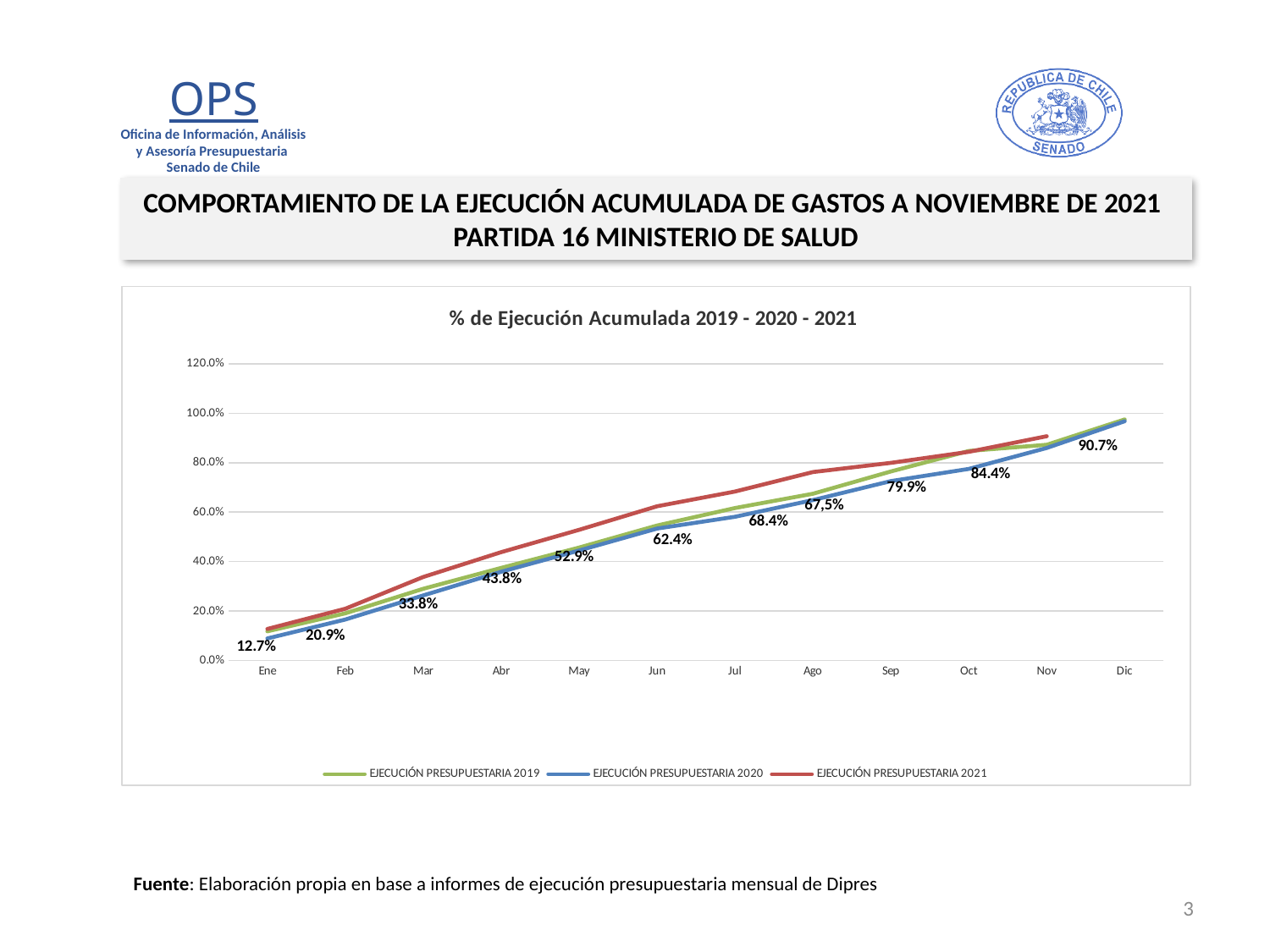
Do the lines rise or fall from Ene to Dic? rise How many months are shown on the x axis? 12 What value is labelled at Feb on the chart? 20.9% What value is labelled at Ene on the chart? 12.7% What value is labelled at Nov on the chart? 90.7% Is the value for EJECUCIÓN PRESUPUESTARIA 2020 at Dic greater or less than 80.0%? greater At Mar, which series is higher: EJECUCIÓN PRESUPUESTARIA 2021 or EJECUCIÓN PRESUPUESTARIA 2020? EJECUCIÓN PRESUPUESTARIA 2021 What is the title of the chart? % de Ejecución Acumulada 2019 - 2020 - 2021 What is the difference between the labelled values at Nov (90.7%) and Ene (12.7%)? 78.0% What kind of chart is shown on the slide? line chart How many series does the legend list? 3 What is the difference between the labelled values at Jun (62.4%) and May (52.9%)? 9.5%